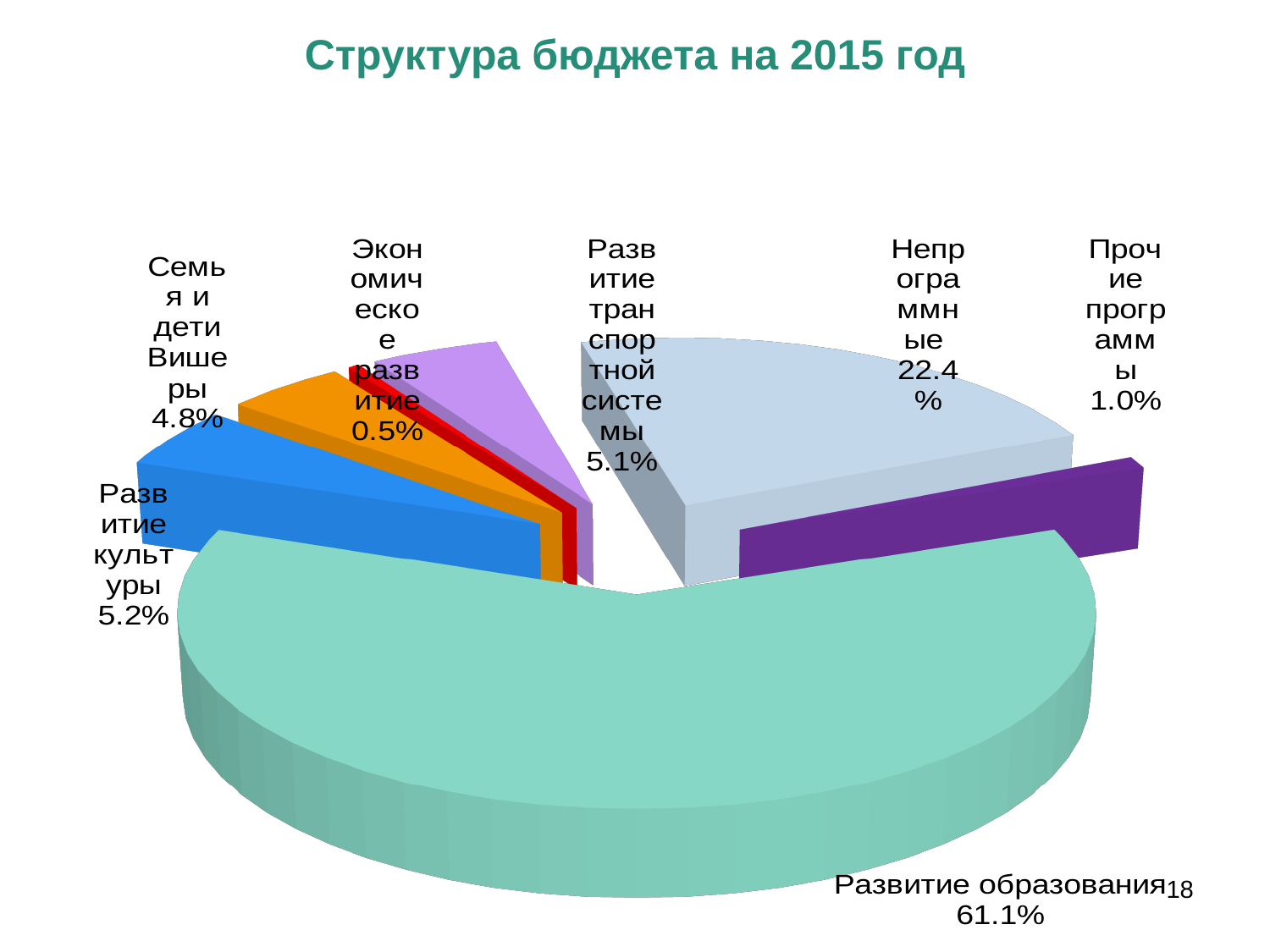
How many categories are shown in the pie chart? 7 What share of the budget goes to Развитие культуры? 5.2% Which has a larger share: Развитие культуры or Семья и дети Вишеры? Развитие культуры What share of the budget is Непрограммные? 22.4% What share of the budget goes to Экономическое развитие? 0.5% What kind of chart is shown on the slide? pie chart Which category has the smallest share of the budget? Экономическое развитие What is the combined share of Развитие транспортной системы and Прочие программы? 6.1% What is the title of the chart? Структура бюджета на 2015 год Which category has the largest share of the budget? Развитие образования What is the difference between the shares of Развитие образования and Непрограммные? 38.7% What share of the budget goes to Развитие образования? 61.1%